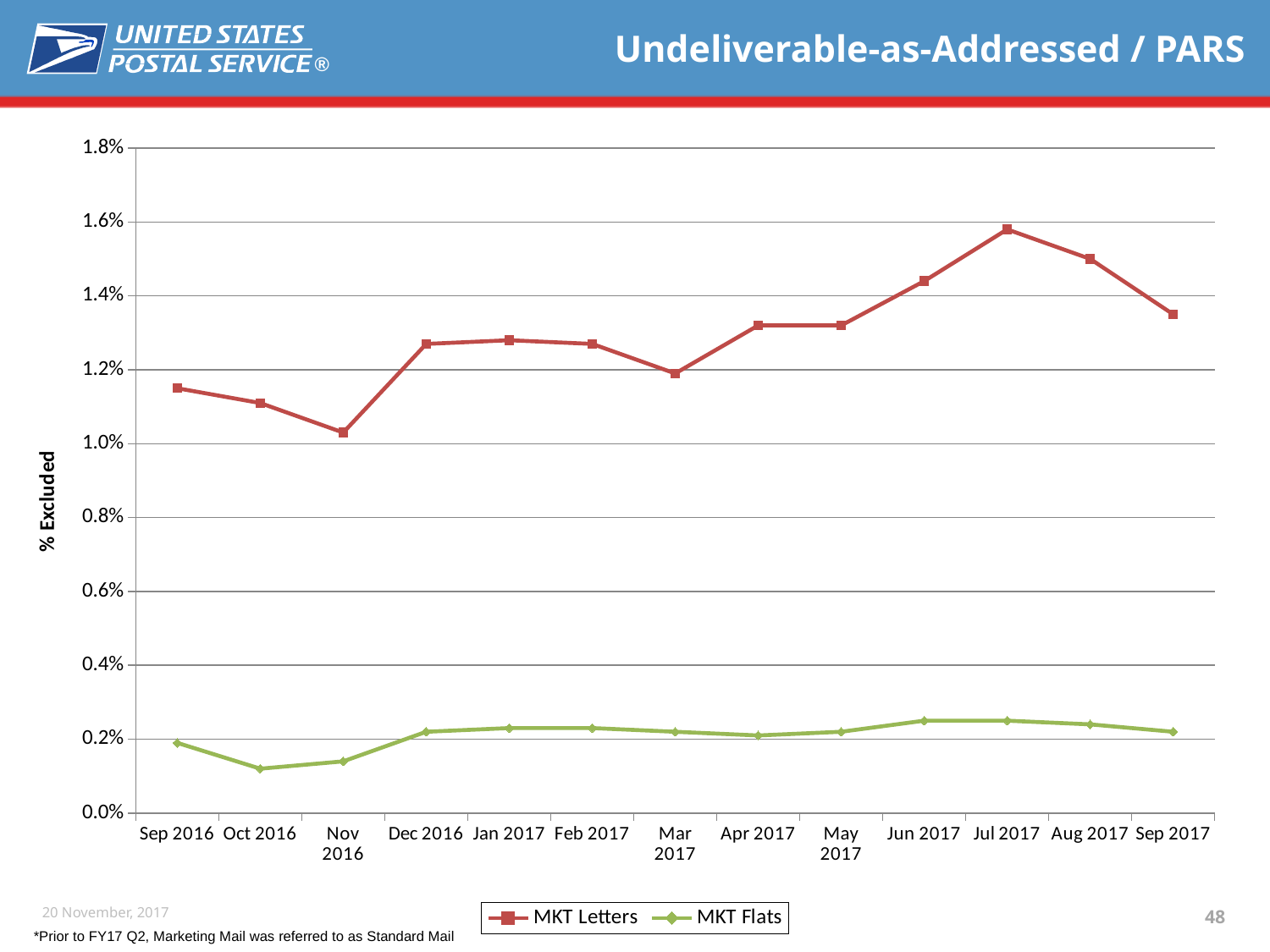
In which month does the MKT Flats series reach its lowest value? Oct 2016 How many series does the legend list? 2 What is the label on the vertical axis? % Excluded Which is larger for MKT Letters: the value for Sep 2016 or the value for Sep 2017? Sep 2017 Does the MKT Letters series rise or fall from Jul 2017 to Sep 2017? fall What kind of chart is shown on the slide? line chart In which month does the MKT Letters series reach its lowest value? Nov 2016 In which month does the MKT Letters series reach its highest value? Jul 2017 Is the MKT Flats value for Jun 2017 greater or less than 0.4%? less Is the MKT Letters value for Nov 2016 greater or less than 1.2%? less Is the MKT Letters value for Jul 2017 greater or less than 1.4%? greater How many months are plotted along the x axis? 13